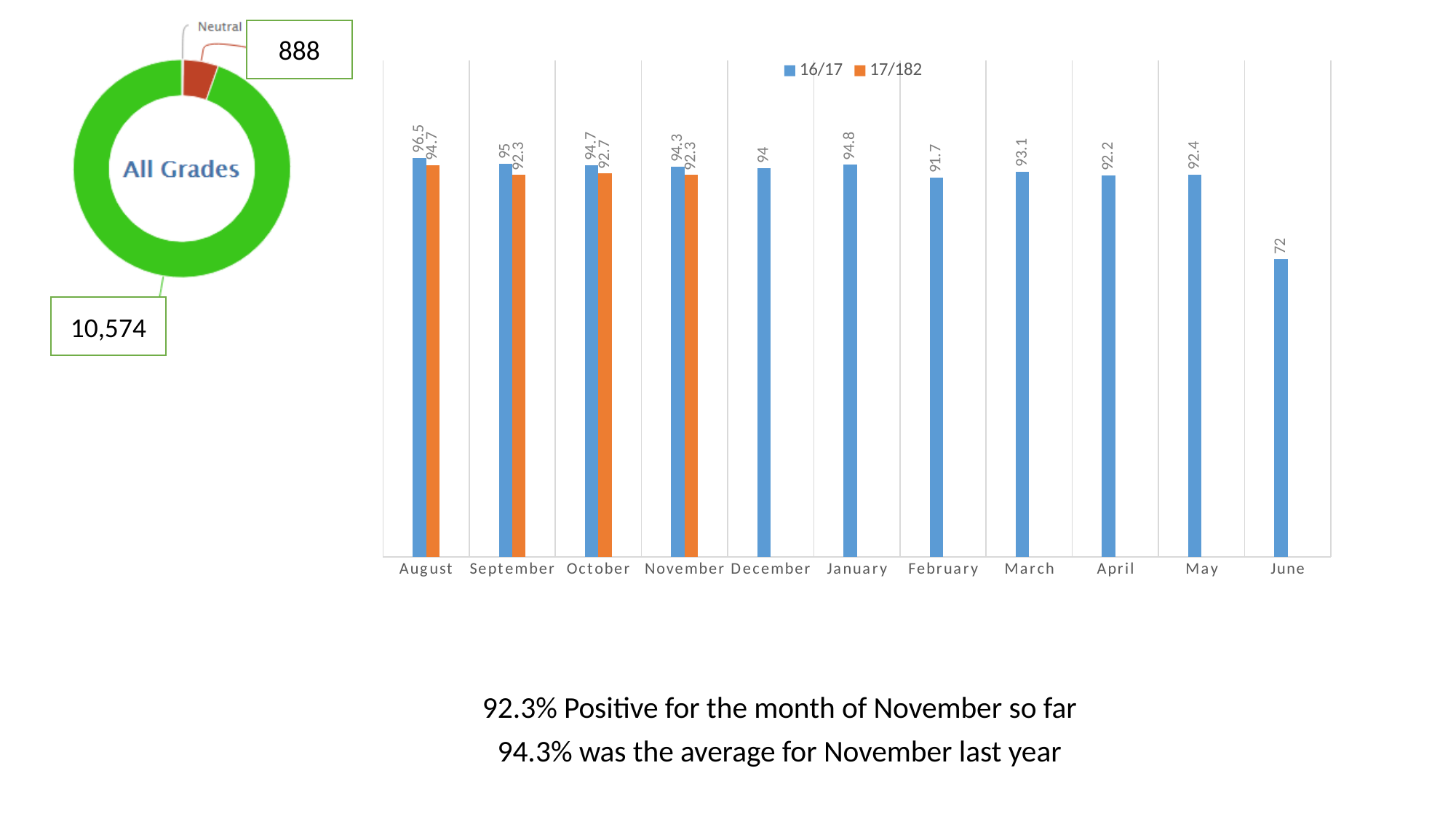
In the bar chart, which is larger in September: the 16/17 value or the 17/182 value? 16/17 In the bar chart, what is the difference between the 16/17 and 17/182 values for November? 2 In the All Grades donut chart, what is the value of the Neutral slice? 888 How many series does the legend of the bar chart list? 2 How many months are shown on the x axis of the bar chart? 11 What kind of chart is the chart on the right of the slide? bar chart In the bar chart, what is the value for 16/17 in August? 96.5 In the bar chart, which month has the lowest 16/17 value? June In the bar chart, which month has the highest 16/17 value? August In the All Grades donut chart, what is the value of the green segment? 10,574 In the bar chart, what is the value for 16/17 in June? 72 In the bar chart, what is the value for 17/182 in October? 92.7